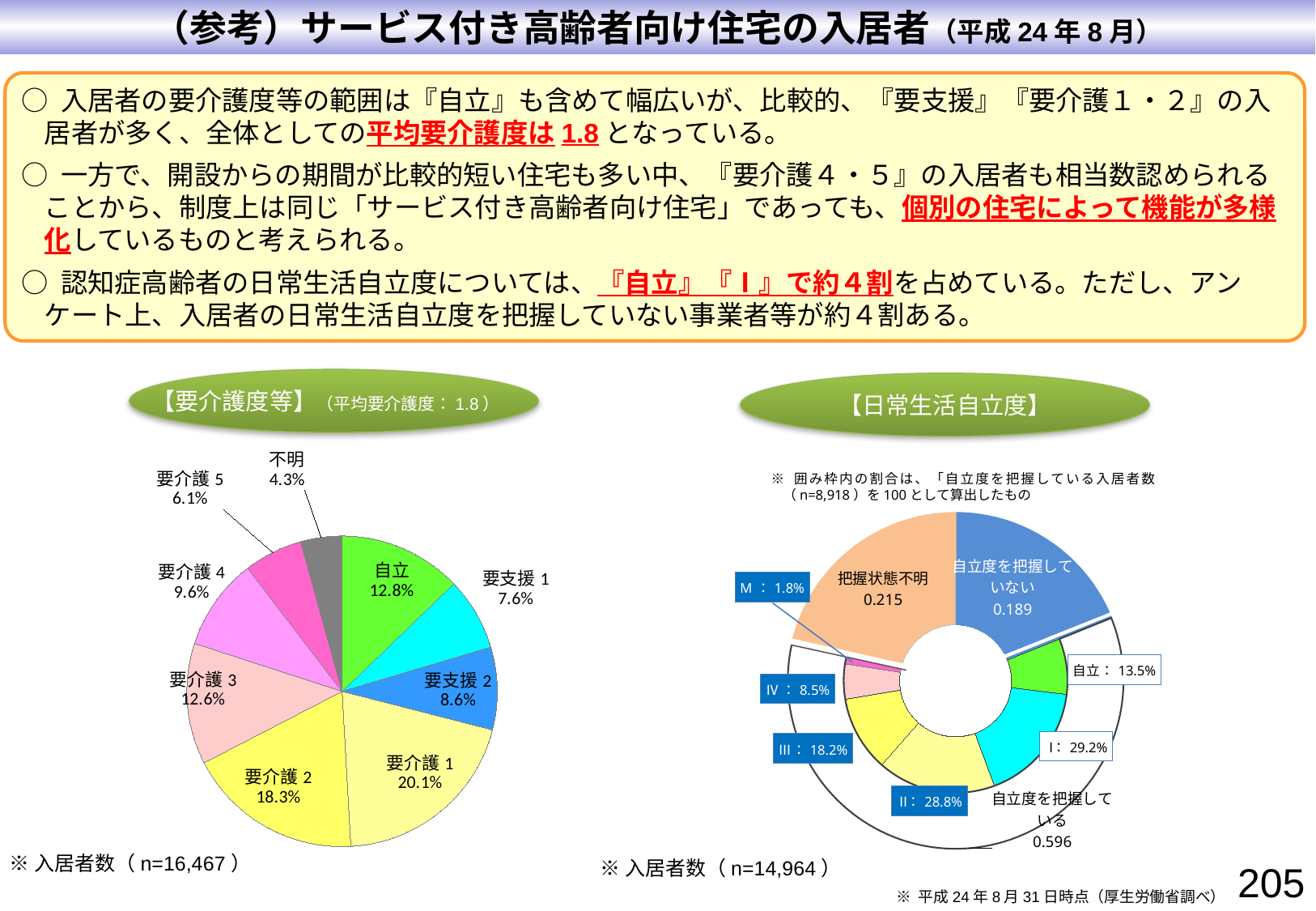
In the 【日常生活自立度】 chart, what is the value for 自立度を把握している? 0.596 What kind of chart is the 【要介護度等】 chart? pie chart In the 【要介護度等】 pie chart, what is the value for 自立? 12.8% How many categories are shown in the 【要介護度等】 pie chart? 9 In the 【日常生活自立度】 chart, what is the difference between 把握状態不明 and 自立度を把握していない? 0.026 In the 【日常生活自立度】 chart, what is the value for I? 29.2% In the 【要介護度等】 pie chart, what is the value for 要介護1? 20.1% In the 【要介護度等】 pie chart, which is larger, 要介護3 or 要介護4? 要介護3 In the 【要介護度等】 pie chart, which category has the smallest share? 不明 In the 【日常生活自立度】 chart, which is larger, II or III? II In the 【要介護度等】 pie chart, what is the difference between 要介護1 and 要介護2? 1.8% In the 【要介護度等】 pie chart, which category has the largest share? 要介護1